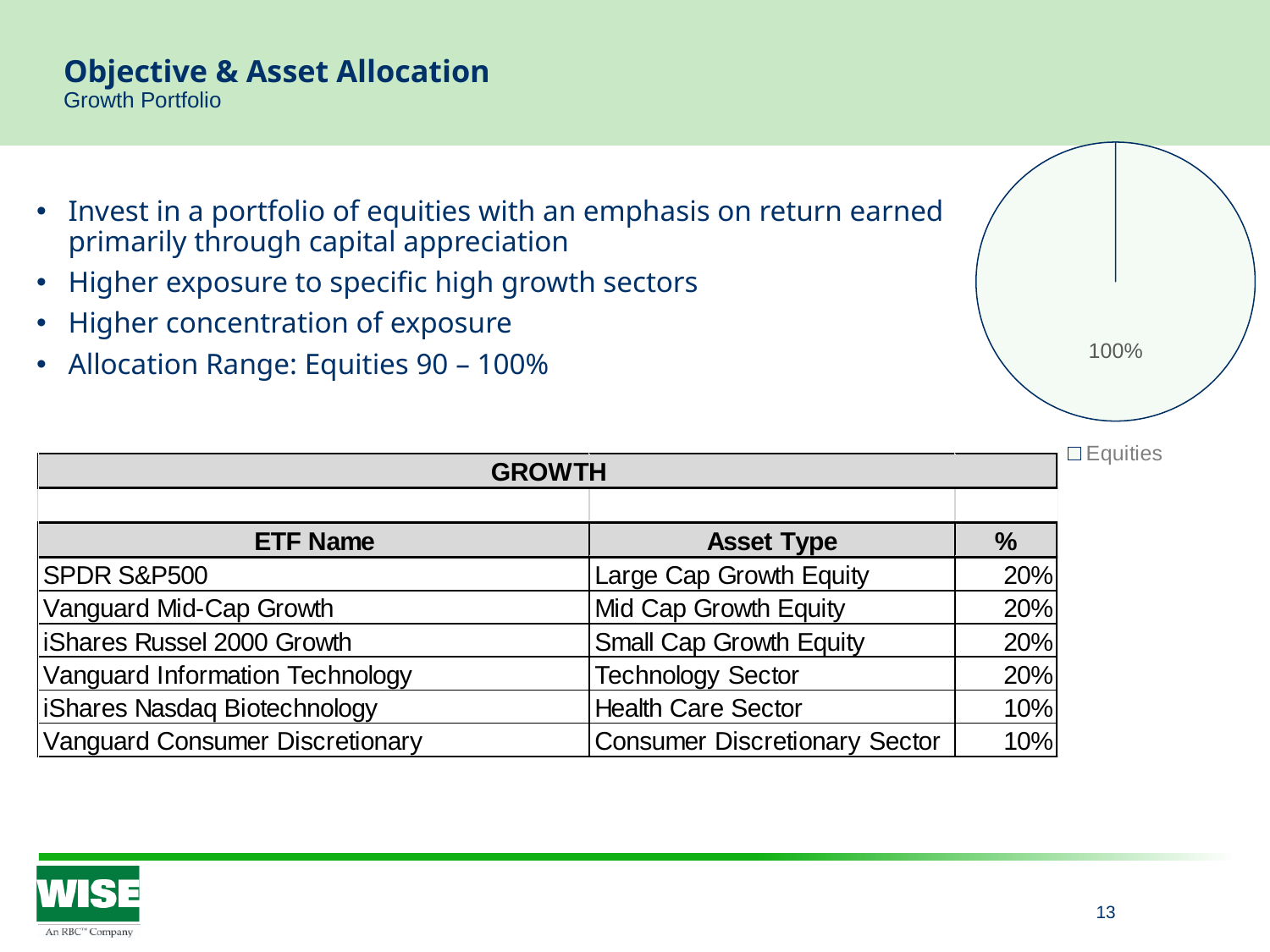
What share of the pie does the Equities slice take? 100% What kind of chart is shown on the slide? pie chart How many slices does the pie chart have? 1 Is the value shown on the pie chart greater or less than 50%? greater How many entries does the pie chart's legend list? 1 What is the name of the only category in the pie chart's legend? Equities What value is labelled on the pie chart? 100%